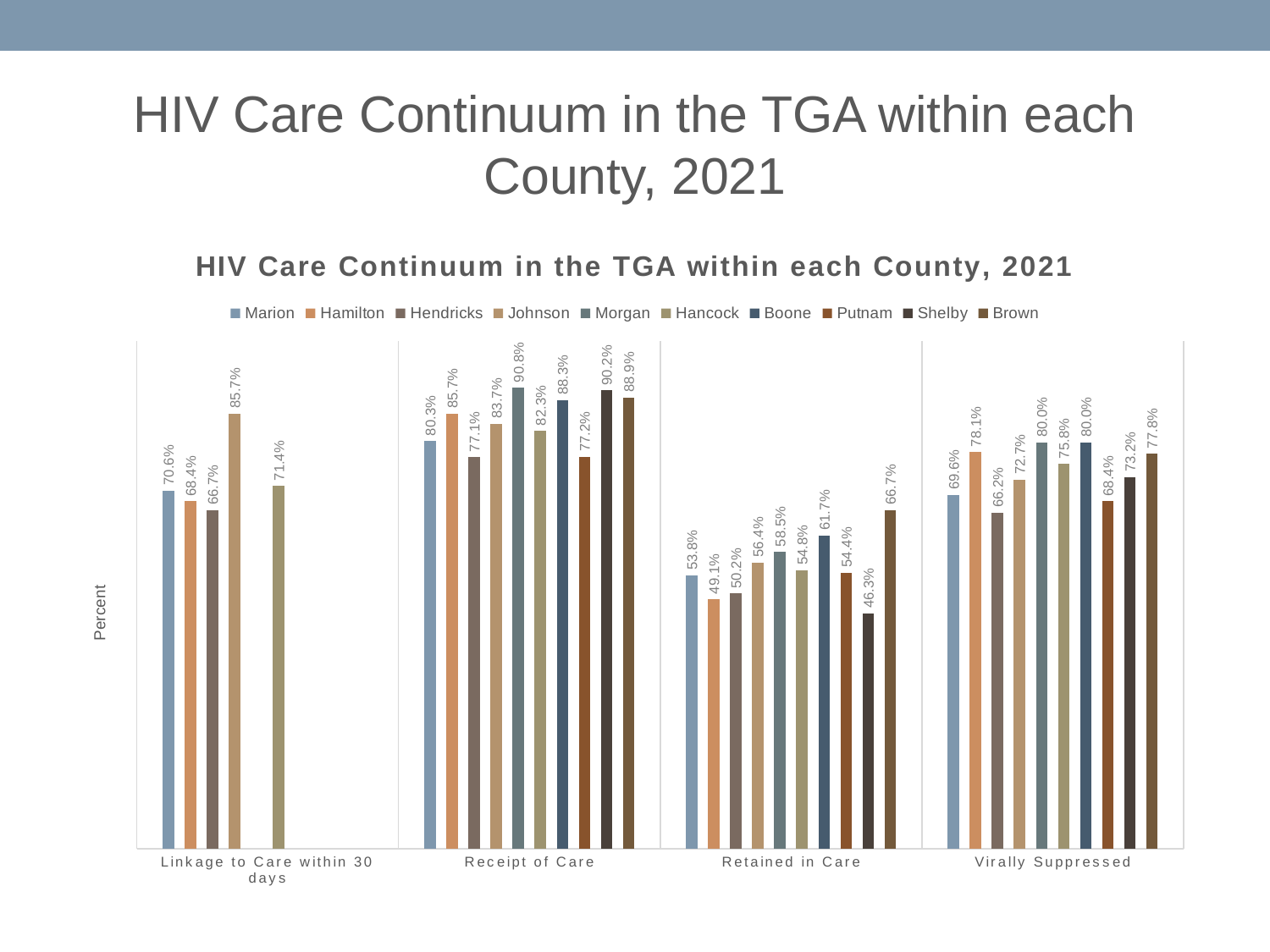
What is the Linkage to Care within 30 days value for Johnson? 85.7% How many care continuum stages are shown on the x axis? 4 Which county has the highest Receipt of Care value? Morgan What is the Receipt of Care value for Morgan? 90.8% Which is larger for Receipt of Care: Hamilton or Hendricks? Hamilton Which county has the lowest Virally Suppressed value? Hendricks Which county has the lowest Retained in Care value? Shelby What is the Virally Suppressed value for Hamilton? 78.1% What is the Retained in Care value for Brown? 66.7% What is the difference between Brown's and Shelby's Retained in Care values? 20.4% How many counties are listed in the legend? 10 What type of chart is shown on the slide? Bar chart